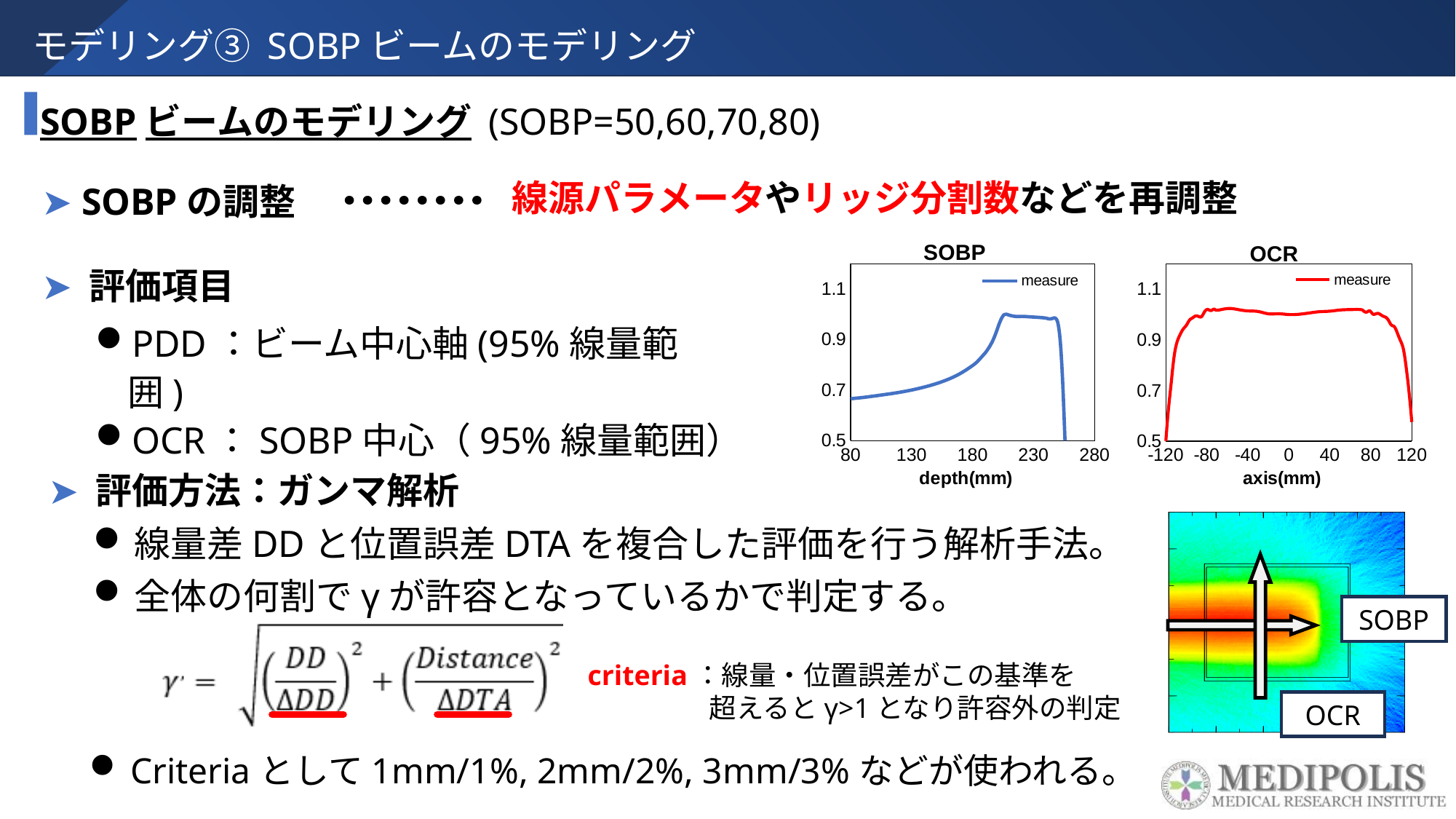
In the SOBP chart, does the measured value rise or fall as depth increases from 80 mm to 180 mm? rise What kind of chart is the SOBP chart? line chart What is the name of the series shown in the OCR chart's legend? measure In the SOBP chart, is the value at a depth of 230 mm greater or less than 0.9? greater In the OCR chart, is the value at axis position -120 mm greater or less than 0.7? less In the OCR chart, which is larger: the value at axis position 120 mm or the value at axis position 40 mm? 40 mm In the OCR chart, is the value at axis position 0 mm greater or less than 0.9? greater How many series does the legend of the SOBP chart list? 1 What is the x-axis label of the SOBP chart? depth(mm) In the SOBP chart, which is larger: the value at a depth of 130 mm or the value at a depth of 230 mm? 230 mm What kind of chart is the OCR chart? line chart